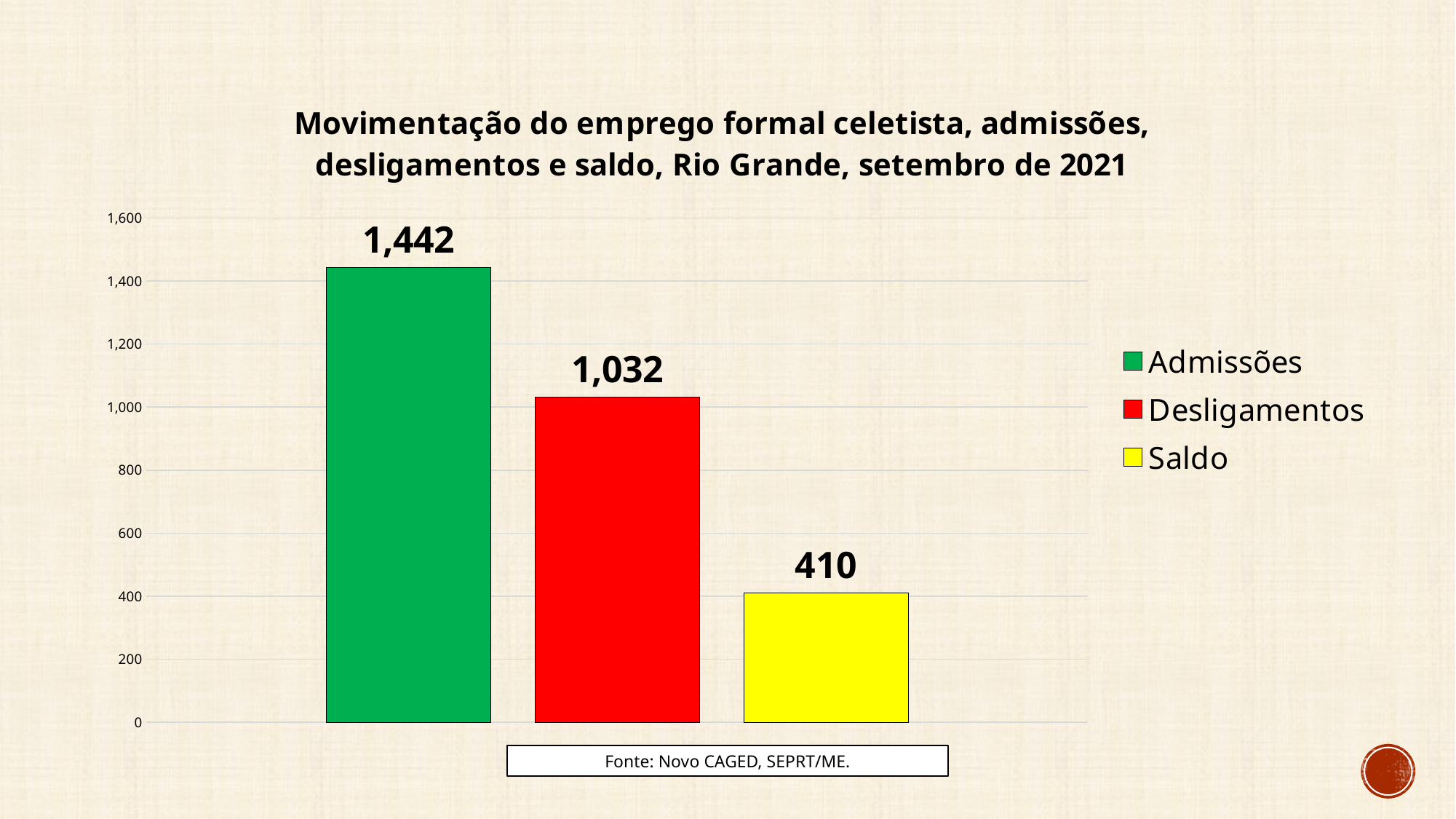
How many series does the legend list? 3 What is the value for Desligamentos? 1,032 Is the value for Desligamentos greater or less than 1,000? greater Which is larger, Desligamentos or Saldo? Desligamentos What is the difference between Admissões and Desligamentos? 410 Which series has the highest value? Admissões What is the value for Saldo? 410 Which series has the lowest value? Saldo What is the value for Admissões? 1,442 What kind of chart is shown on the slide? bar chart How many bars are plotted in the chart? 3 What is the difference between Desligamentos and Saldo? 622